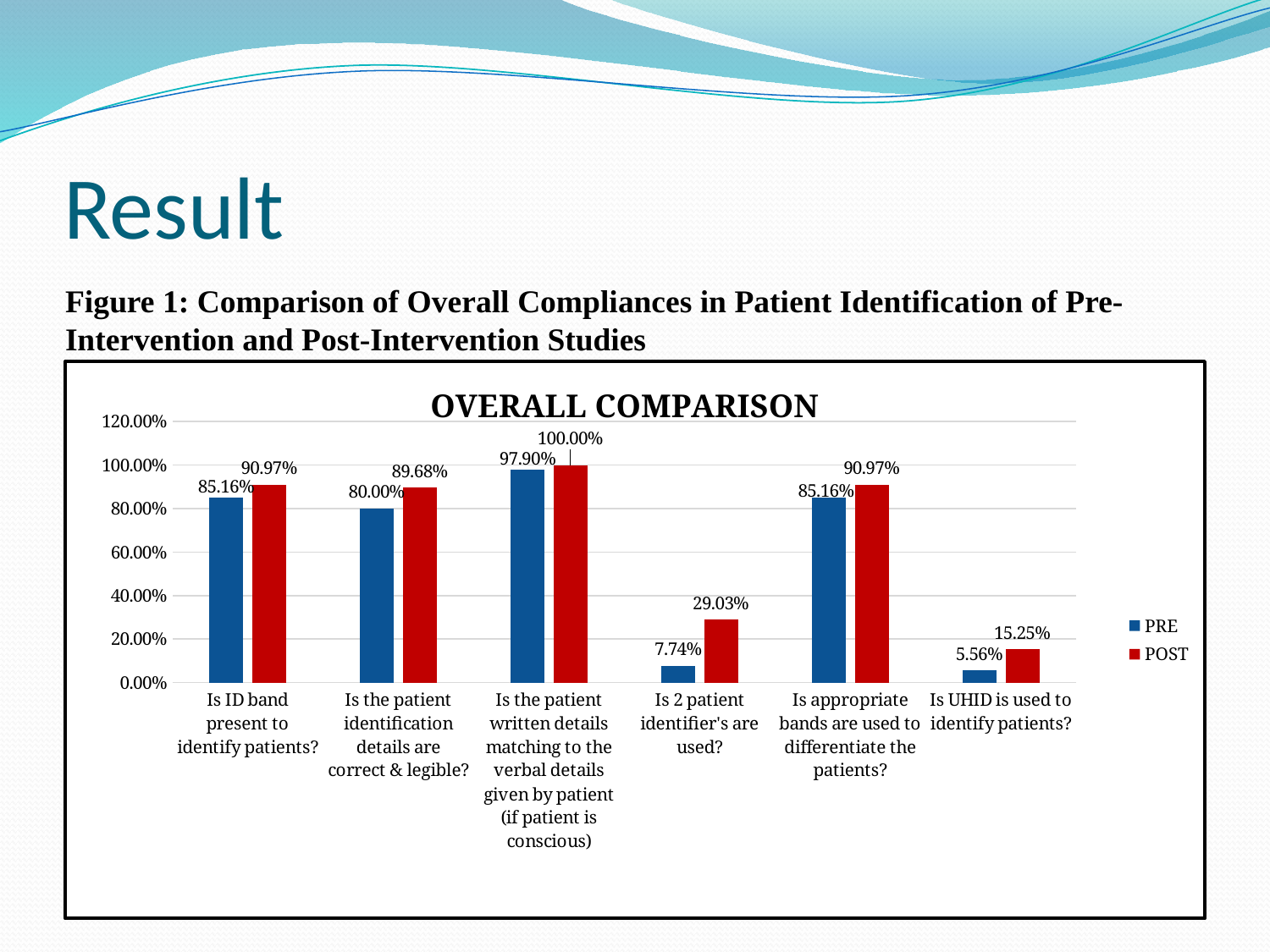
How many categories are shown on the x axis? 6 How many series does the legend list? 2 What is the POST value for "Is 2 patient identifier's are used?"? 29.03% What is the PRE value for "Is UHID is used to identify patients?"? 5.56% What is the difference between the POST and PRE values for "Is the patient identification details are correct & legible?"? 9.68% Which category has the lowest PRE value? Is UHID is used to identify patients? Which is larger, the PRE value for "Is ID band present to identify patients?" or the PRE value for "Is 2 patient identifier's are used?"? Is ID band present to identify patients? Which category has the highest POST value? Is the patient written details matching to the verbal details given by patient (if patient is conscious) What is the PRE value for "Is the patient identification details are correct & legible?"? 80.00% What kind of chart is shown? Bar chart What is the title of the chart? OVERALL COMPARISON What is the difference between the POST and PRE values for "Is 2 patient identifier's are used?"? 21.29%